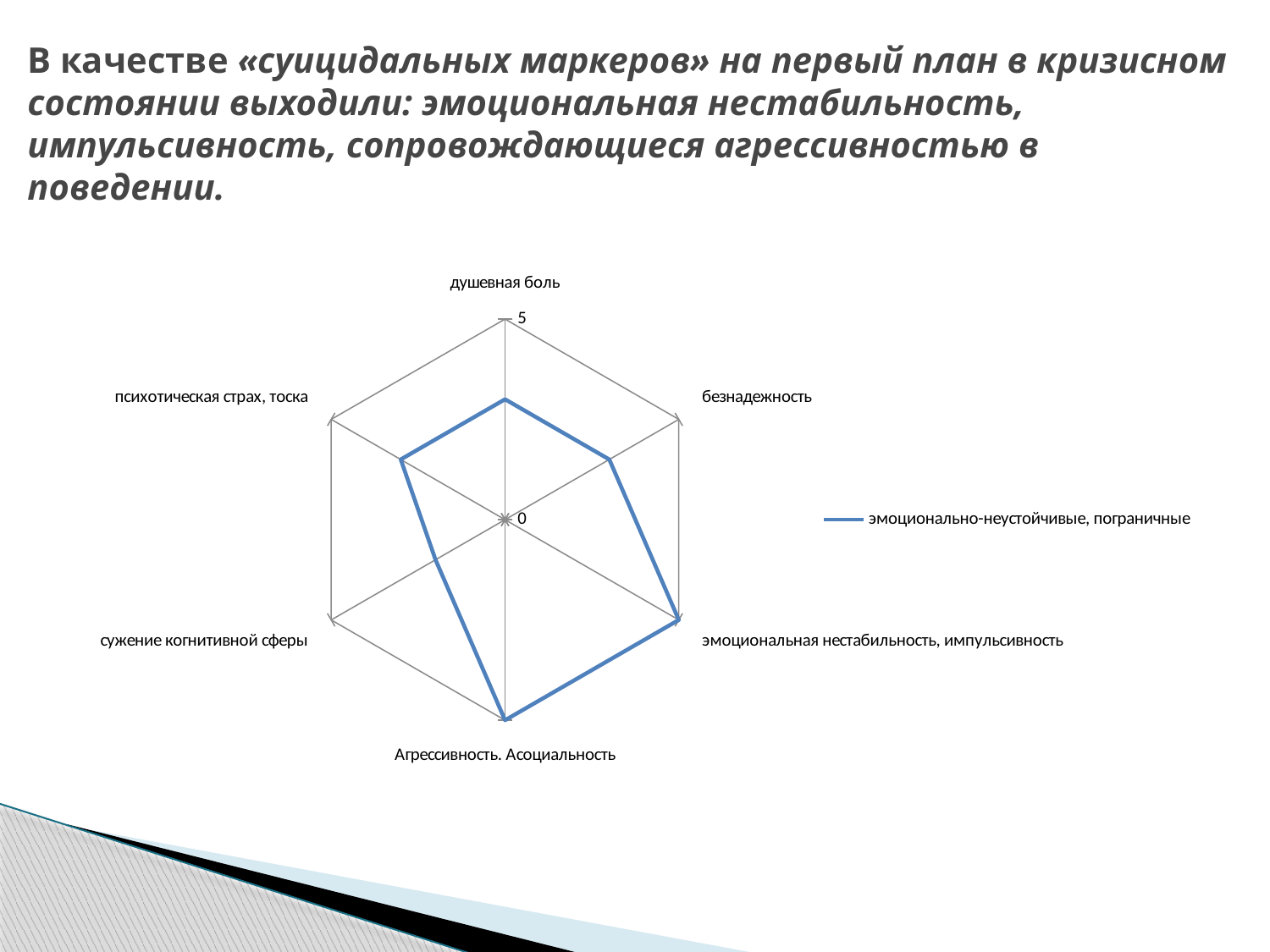
What kind of chart is shown on the slide? Radar chart How many series does the legend list? 1 How many categories (axes) does the radar chart have? 6 Is the value for сужение когнитивной сферы greater or less than 5? less What is the maximum value shown on the radar chart's axis? 5 Which is larger: the value for эмоциональная нестабильность, импульсивность or the value for сужение когнитивной сферы? эмоциональная нестабильность, импульсивность Which is larger: the value for душевная боль or the value for сужение когнитивной сферы? душевная боль Which is larger: the value for Агрессивность. Асоциальность or the value for безнадежность? Агрессивность. Асоциальность Is the value for безнадежность greater or less than 5? less What is the name of the series shown in the legend? эмоционально-неустойчивые, пограничные Which category has the lowest value on the radar chart? сужение когнитивной сферы